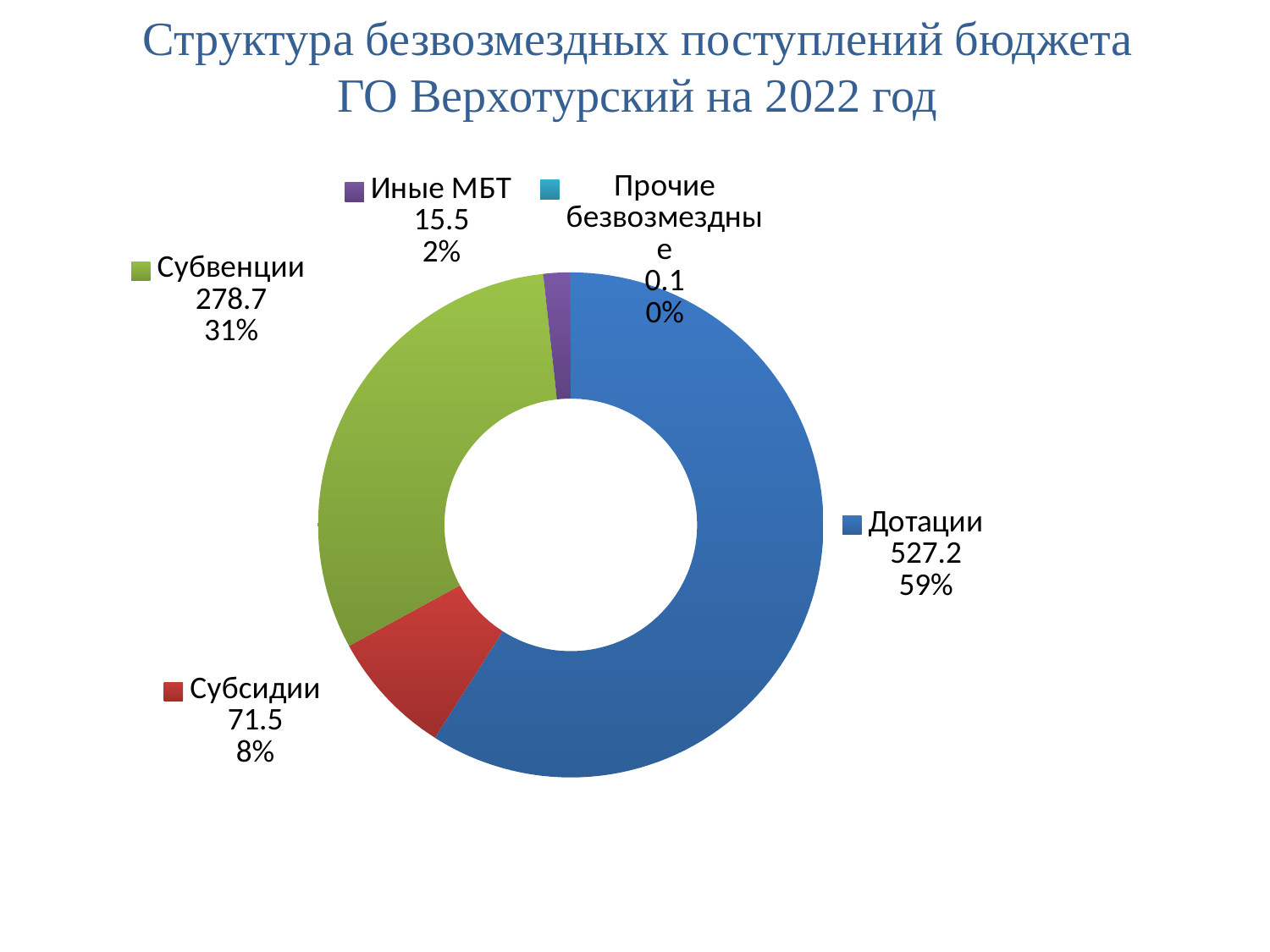
What percentage share does Субсидии have? 8% What value is shown for Субсидии? 71.5 How many categories are shown in the chart? 5 What value is shown for Иные МБТ? 15.5 What percentage share does Субвенции have? 31% What value is shown for Субвенции? 278.7 What type of chart is shown on the slide? Doughnut (pie) chart Which is larger, the value for Субсидии or the value for Иные МБТ? Субсидии Which category has the smallest share of the chart? Прочие безвозмездные What value is shown for Дотации? 527.2 Which category has the largest share of the chart? Дотации What is the difference between the values for Дотации and Субвенции? 248.5